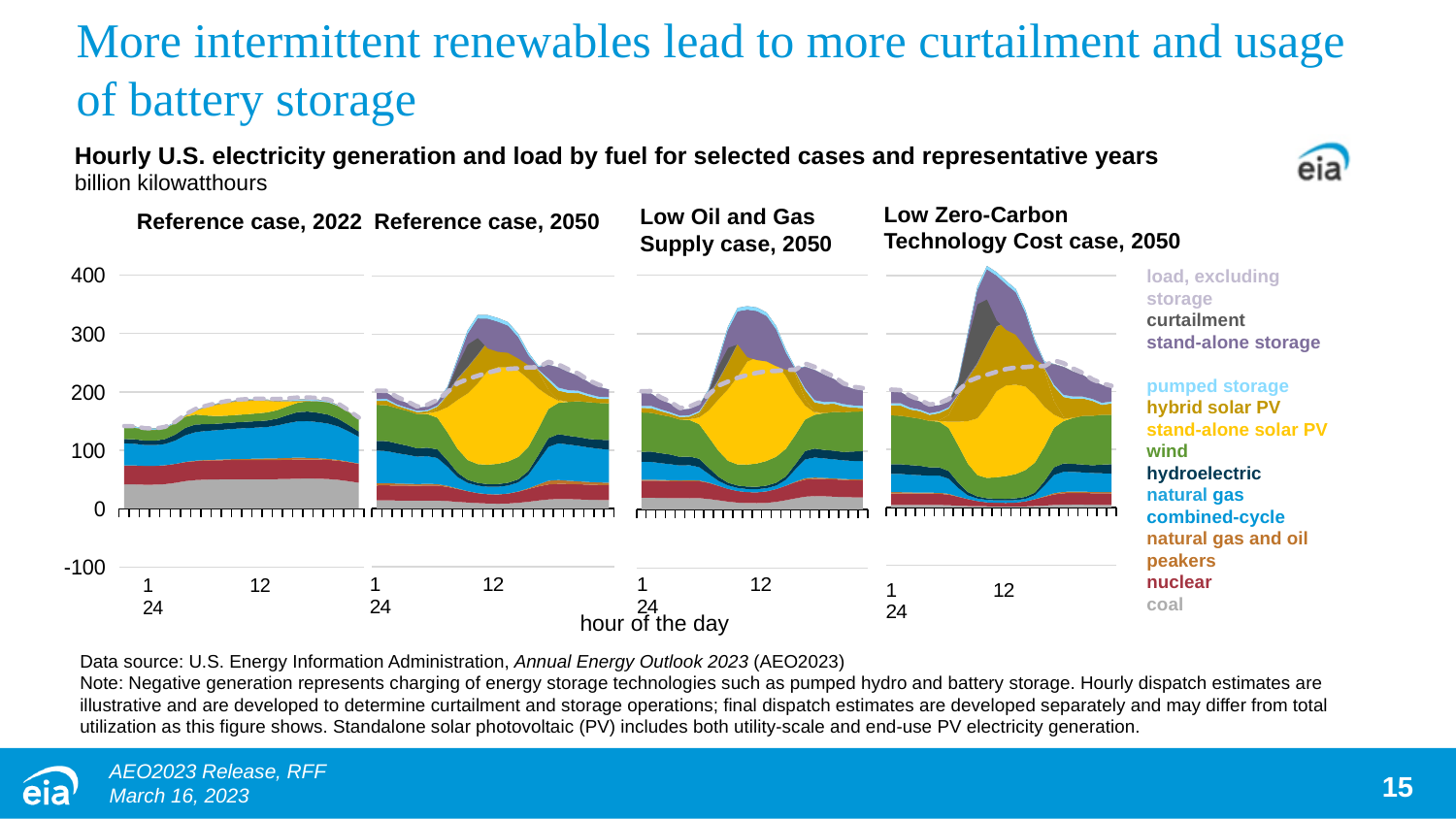
Which of the four panels shows the lowest peak in total generation? Reference case, 2022 In the Reference case, 2022 panel, is the peak total generation greater or less than 300? less Which of the four panels shows the highest peak in total generation? Low Zero-Carbon Technology Cost case, 2050 How many entries does the legend on the right list? 12 In the Low Oil and Gas Supply case, 2050 panel, is the peak total generation greater or less than 400? less What kind of chart is used in the four panels on this slide? stacked area chart In the Reference case, 2050 panel, is the peak total generation greater or less than 300? greater How many case panels are shown on the slide? 4 In the Reference case, 2022 panel, does total generation rise or fall from hour 1 to hour 12? rise What unit is the y-axis measured in? billion kilowatthours